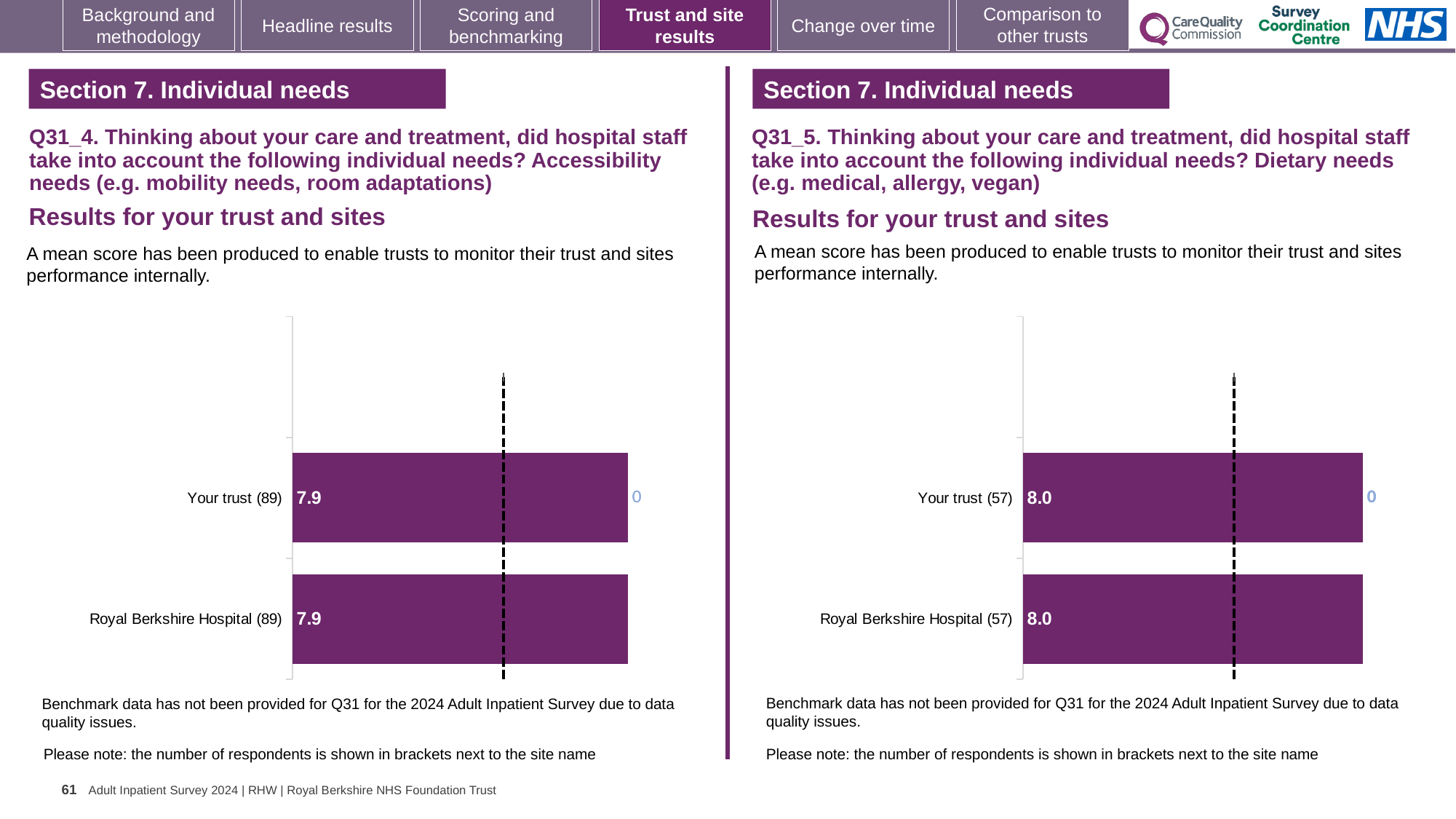
What kind of chart is used in the left chart (Q31_4, Accessibility needs)? Bar chart How many bars are plotted in the right chart (Q31_5, Dietary needs)? 2 In the left chart (Q31_4, Accessibility needs), how many respondents are shown in brackets next to Your trust? 89 In the left chart (Q31_4, Accessibility needs), what is the mean score for Royal Berkshire Hospital? 7.9 In the right chart (Q31_5, Dietary needs), how many respondents are shown in brackets next to Royal Berkshire Hospital? 57 In the left chart (Q31_4, Accessibility needs), what is the difference between the scores for Your trust and Royal Berkshire Hospital? 0.0 What is the difference between the Your trust score in the right chart (Q31_5, Dietary needs) and the Your trust score in the left chart (Q31_4, Accessibility needs)? 0.1 In the right chart (Q31_5, Dietary needs), what is the mean score for Your trust? 8.0 In the left chart (Q31_4, Accessibility needs), what is the mean score for Your trust? 7.9 How many bars are plotted in the left chart (Q31_4, Accessibility needs)? 2 What kind of chart is used in the right chart (Q31_5, Dietary needs)? Bar chart In the right chart (Q31_5, Dietary needs), what is the mean score for Royal Berkshire Hospital? 8.0